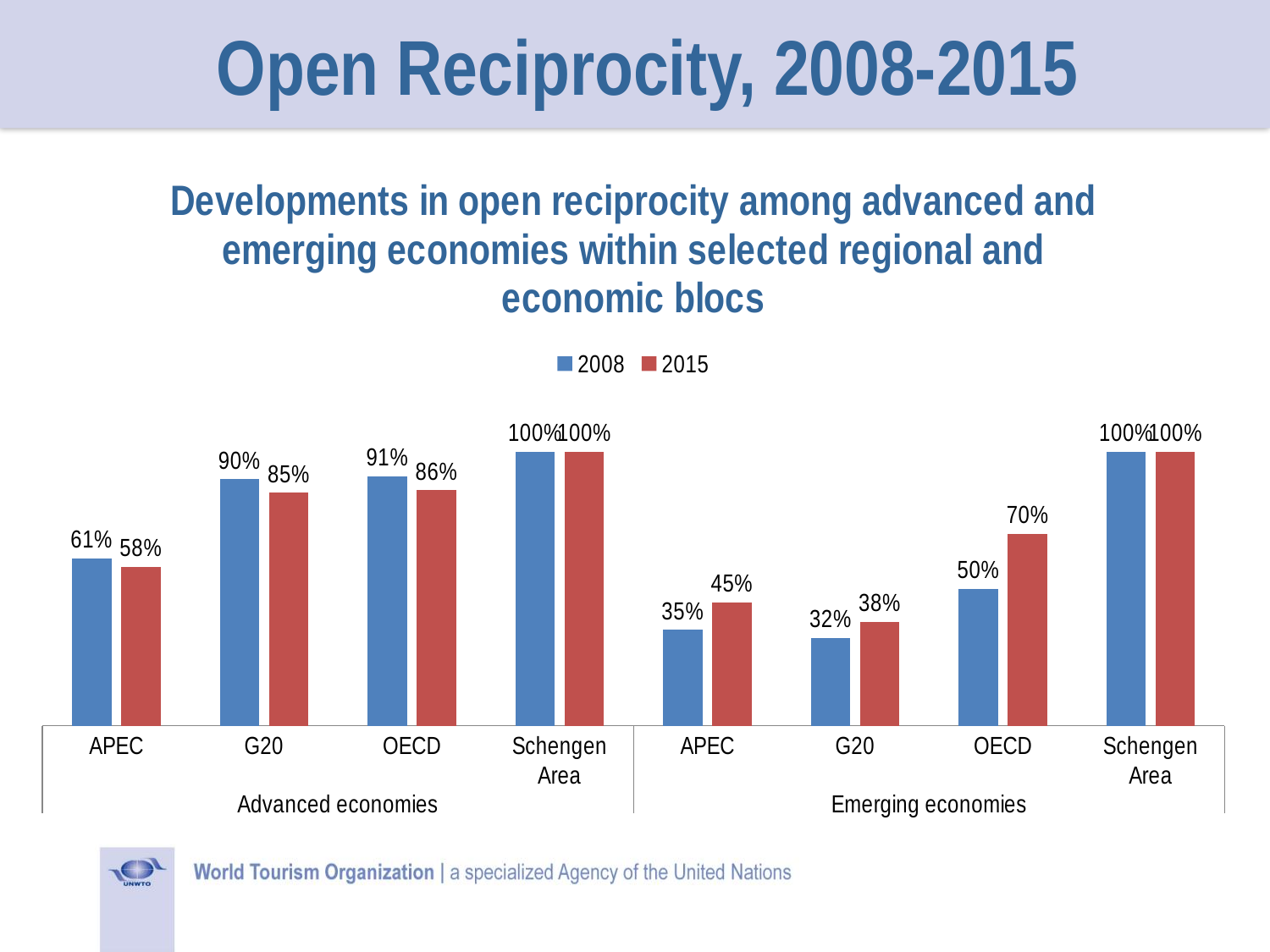
What is the 2008 value for APEC among advanced economies? 61% What is the 2008 value for G20 among emerging economies? 32% Which is larger for APEC among advanced economies: the 2008 value or the 2015 value? 2008 Which colour represents the 2015 series in the chart? Red What is the difference between the 2015 and 2008 values for OECD among emerging economies? 20% Which bloc has the lowest 2008 value among emerging economies? G20 What kind of chart is shown on the slide? Bar chart What is the 2015 value for OECD among emerging economies? 70% Which is larger for APEC among emerging economies: the 2008 value or the 2015 value? 2015 Which bloc has the lowest 2015 value among advanced economies? APEC How many series does the legend list? 2 What is the 2015 value for G20 among advanced economies? 85%